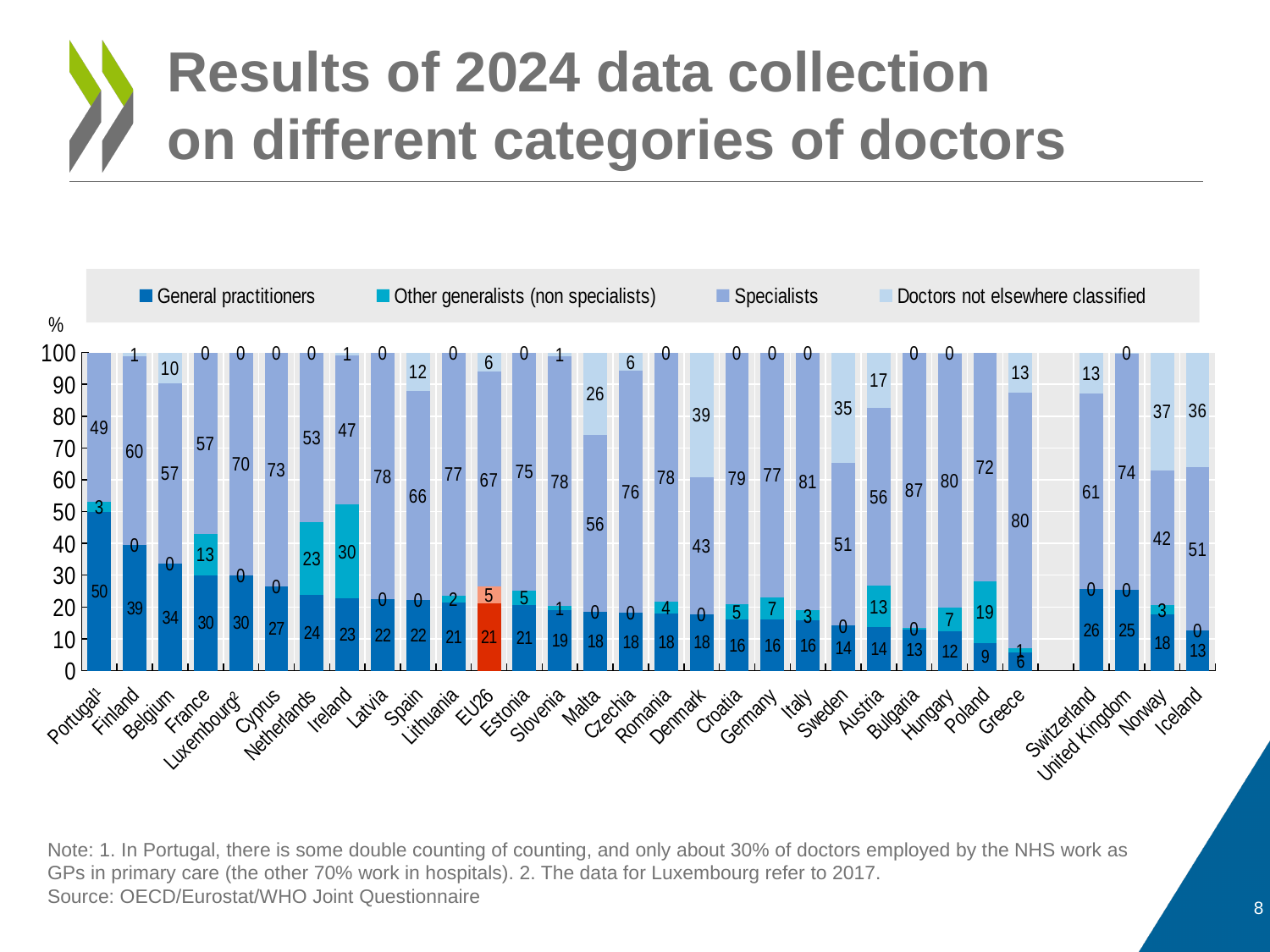
Which has the larger value for Specialists, Italy or Germany? Italy What kind of chart is shown on the slide? Stacked bar chart What is the value for Specialists in Bulgaria? 87 What is the difference between the General practitioners values for Finland and Belgium? 5 What is the value for Other generalists (non specialists) in Ireland? 30 What is the value for General practitioners in Portugal? 50 Which country has the highest value for General practitioners? Portugal Which country has the lowest value for General practitioners? Greece Which country has the highest value for Specialists? Bulgaria How many series does the legend list? 4 What is the value for Doctors not elsewhere classified in Denmark? 39 What is the value for Doctors not elsewhere classified in Malta? 26